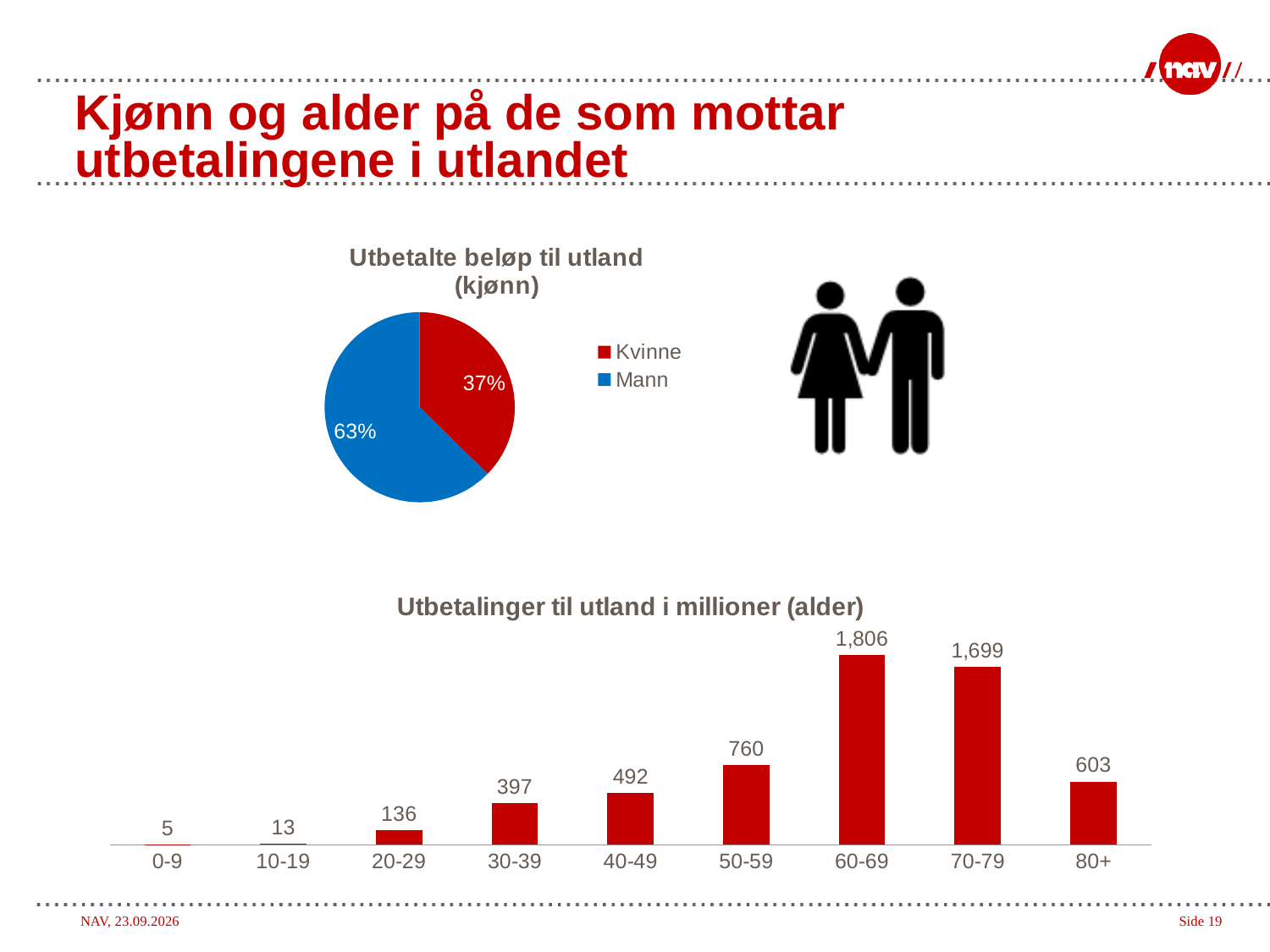
In the bar chart 'Utbetalinger til utland i millioner (alder)', what is the difference between the values for 60-69 and 70-79? 107 In the bar chart 'Utbetalinger til utland i millioner (alder)', which age group has the highest value? 60-69 In the bar chart 'Utbetalinger til utland i millioner (alder)', what is the value for 30-39? 397 In the bar chart 'Utbetalinger til utland i millioner (alder)', which is larger, the value for 50-59 or the value for 80+? 50-59 In the bar chart 'Utbetalinger til utland i millioner (alder)', what is the value for 60-69? 1,806 In the bar chart 'Utbetalinger til utland i millioner (alder)', which age group has the lowest value? 0-9 How many age groups are shown in the bar chart 'Utbetalinger til utland i millioner (alder)'? 9 In the pie chart 'Utbetalte beløp til utland (kjønn)', what share is Mann? 63% What type of chart is 'Utbetalinger til utland i millioner (alder)'? Bar chart In the pie chart 'Utbetalte beløp til utland (kjønn)', what share is Kvinne? 37% How many entries does the legend of the pie chart 'Utbetalte beløp til utland (kjønn)' list? 2 In the pie chart 'Utbetalte beløp til utland (kjønn)', which category has the larger share, Kvinne or Mann? Mann